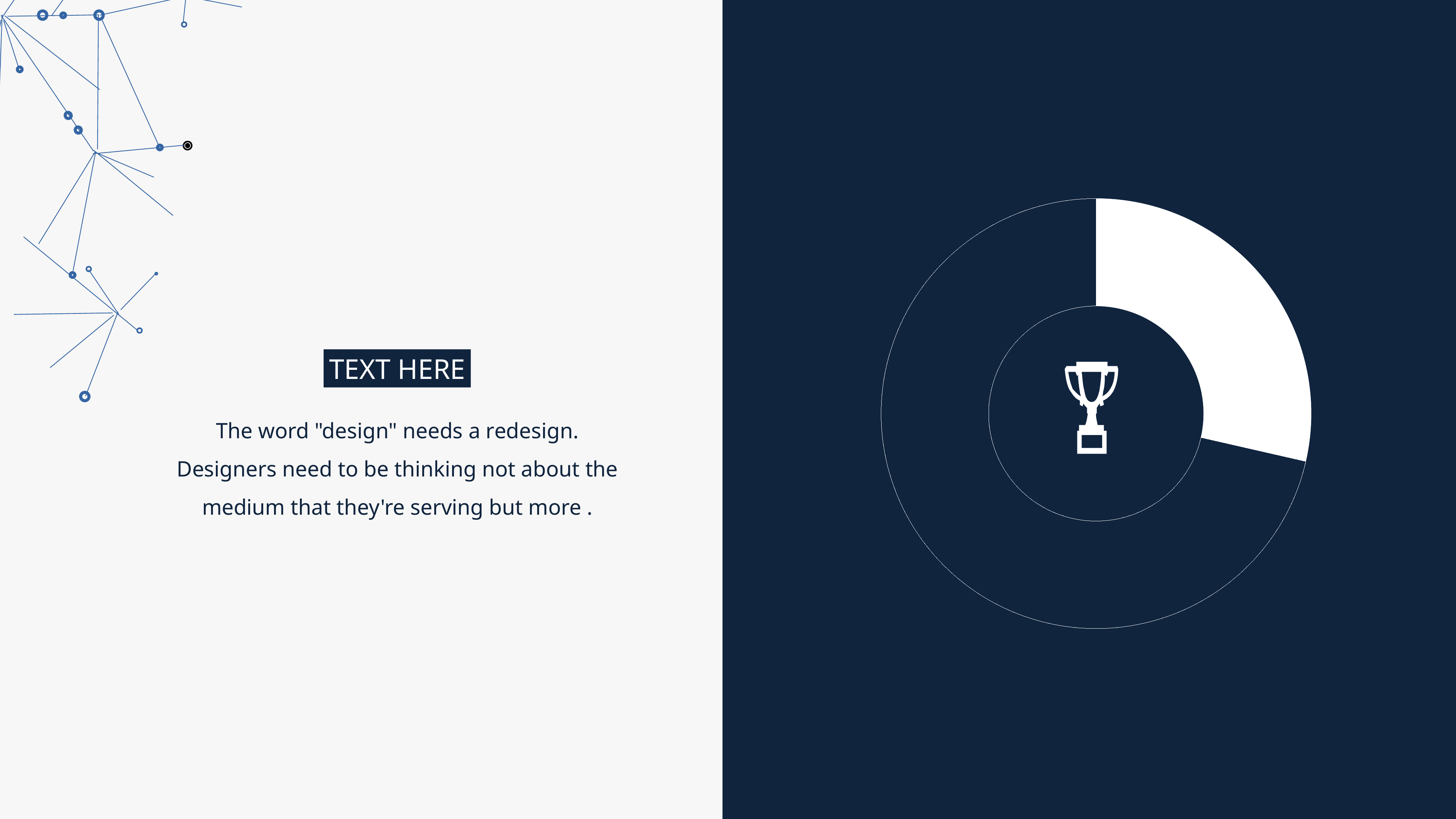
In the doughnut chart on the right, is the white segment more or less than half of the ring? less What kind of chart is shown on the right side of the slide? doughnut chart In the doughnut chart on the right, which segment is larger, the white one or the dark one? the dark one How many segments does the doughnut chart on the right have? 2 What icon is shown in the centre of the doughnut chart on the right? a trophy What colour is the highlighted segment of the doughnut chart on the right? white